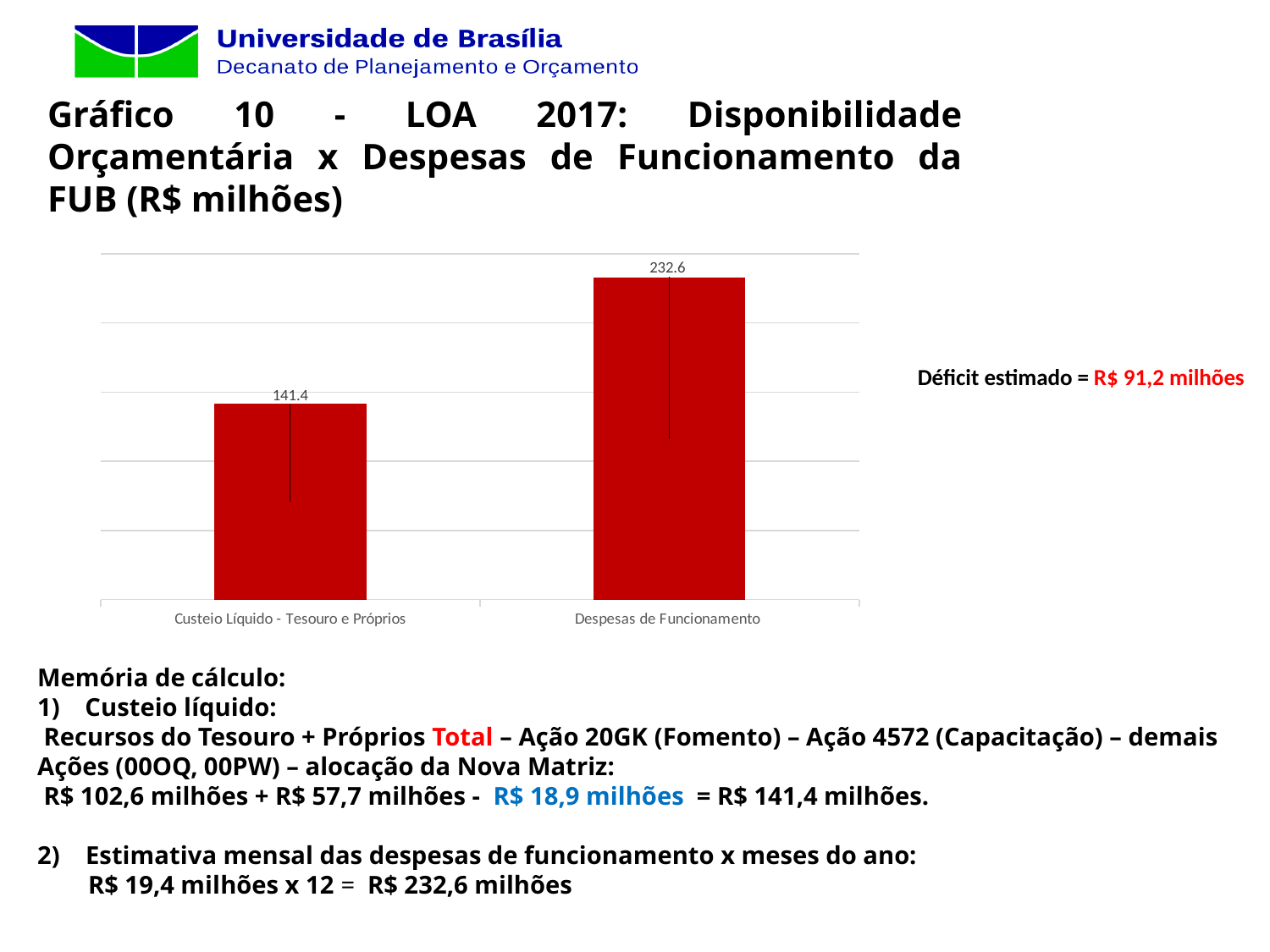
How many categories are shown in the chart? 2 Which category has the highest value? Despesas de Funcionamento What is the value for Despesas de Funcionamento? 232.6 Which category has the lowest value? Custeio Líquido - Tesouro e Próprios Which is larger, Custeio Líquido - Tesouro e Próprios or Despesas de Funcionamento? Despesas de Funcionamento What is the difference between Despesas de Funcionamento and Custeio Líquido - Tesouro e Próprios? 91.2 According to the slide, what is the estimated deficit (Déficit estimado)? R$ 91,2 milhões What kind of chart is shown on the slide? Bar chart What is the value for Custeio Líquido - Tesouro e Próprios? 141.4 Do the values rise or fall from left to right across the categories? Rise What colour are the bars in the chart? Red